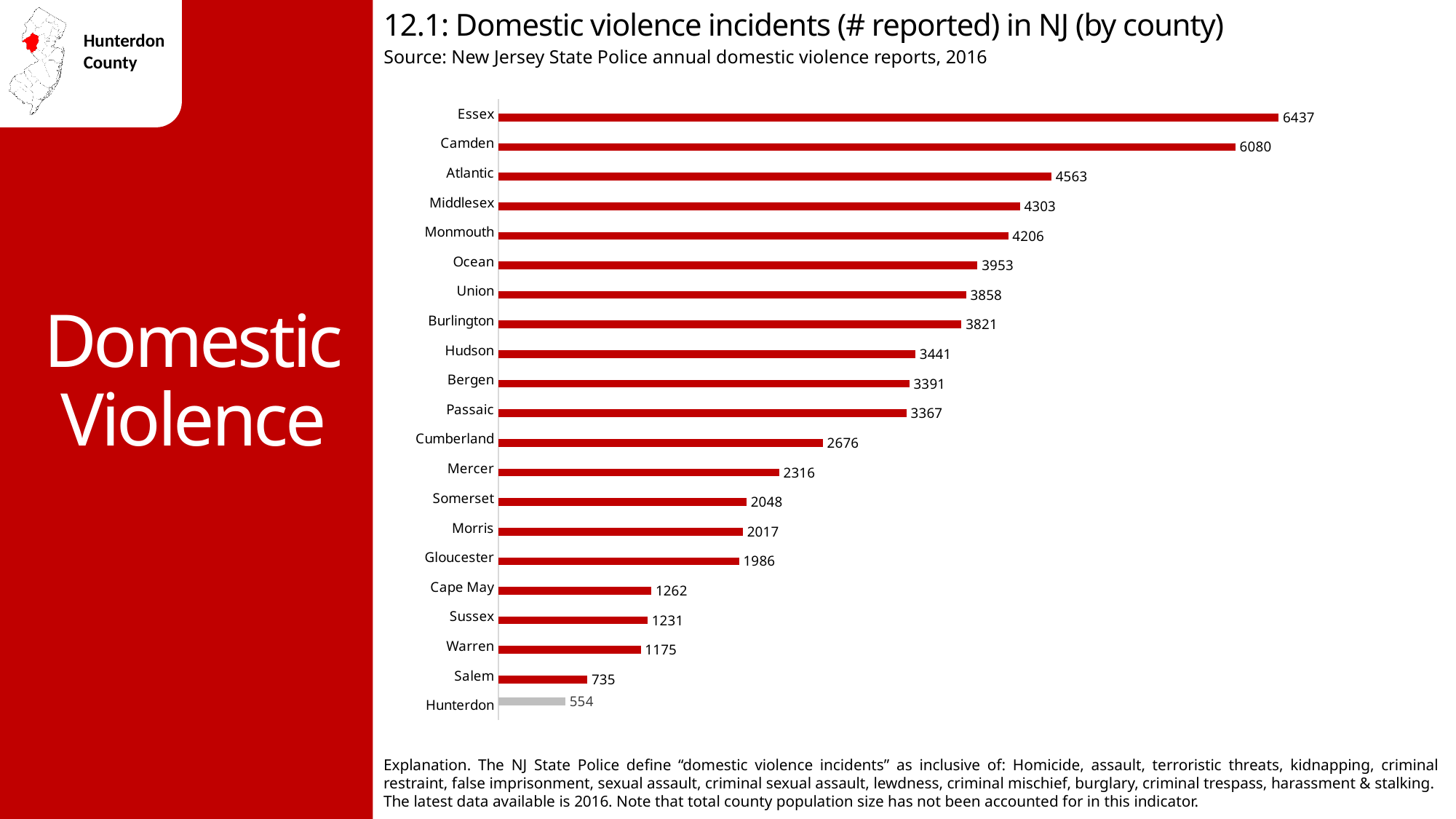
How many counties are shown in the chart? 21 How many incidents were reported in Middlesex county? 4303 Which county's bar is coloured grey instead of red? Hunterdon What is the difference between the values for Salem and Hunterdon? 181 Which county has a larger value, Cape May or Warren? Cape May Which county has the lowest number of reported domestic violence incidents? Hunterdon What is the difference between the values for Essex and Camden? 357 What type of chart is shown on the slide? Bar chart What is the value shown for Hunterdon county? 554 How many domestic violence incidents were reported in Essex county? 6437 Which county has the highest number of reported domestic violence incidents? Essex Which county has a larger value, Hudson or Bergen? Hudson